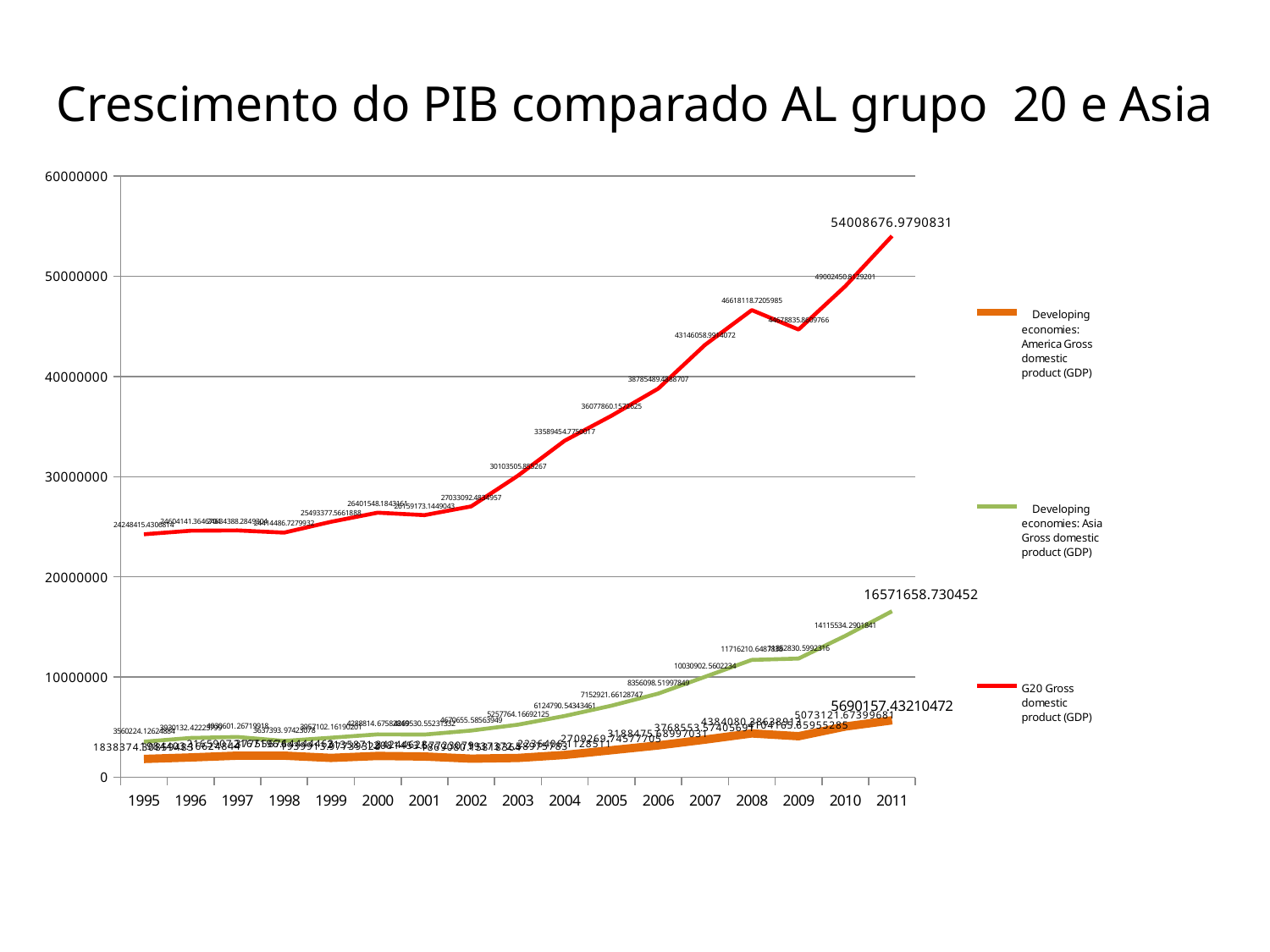
Is the Developing economies: Asia GDP value for 2011 greater or less than 20000000? less Does the G20 Gross domestic product (GDP) series generally rise or fall from 1995 to 2011? rise What is the Developing economies: Asia Gross domestic product (GDP) value for 2011? 16571658.730452 What is the G20 Gross domestic product (GDP) value for 2011? 54008676.9790831 Which series has the highest value in 2011? G20 Gross domestic product (GDP) What is the difference between the G20 GDP and the Developing economies: Asia GDP in 2011? 37437018.2486311 How many series does the legend list? 3 What is the Developing economies: America Gross domestic product (GDP) value for 2010? 5073121.67399681 In 2011, which is larger: the Developing economies: Asia GDP or the Developing economies: America GDP? Developing economies: Asia Gross domestic product (GDP) What type of chart is shown on the slide? line chart How many years are plotted along the x axis? 17 What is the Developing economies: America Gross domestic product (GDP) value for 2011? 5690157.43210472